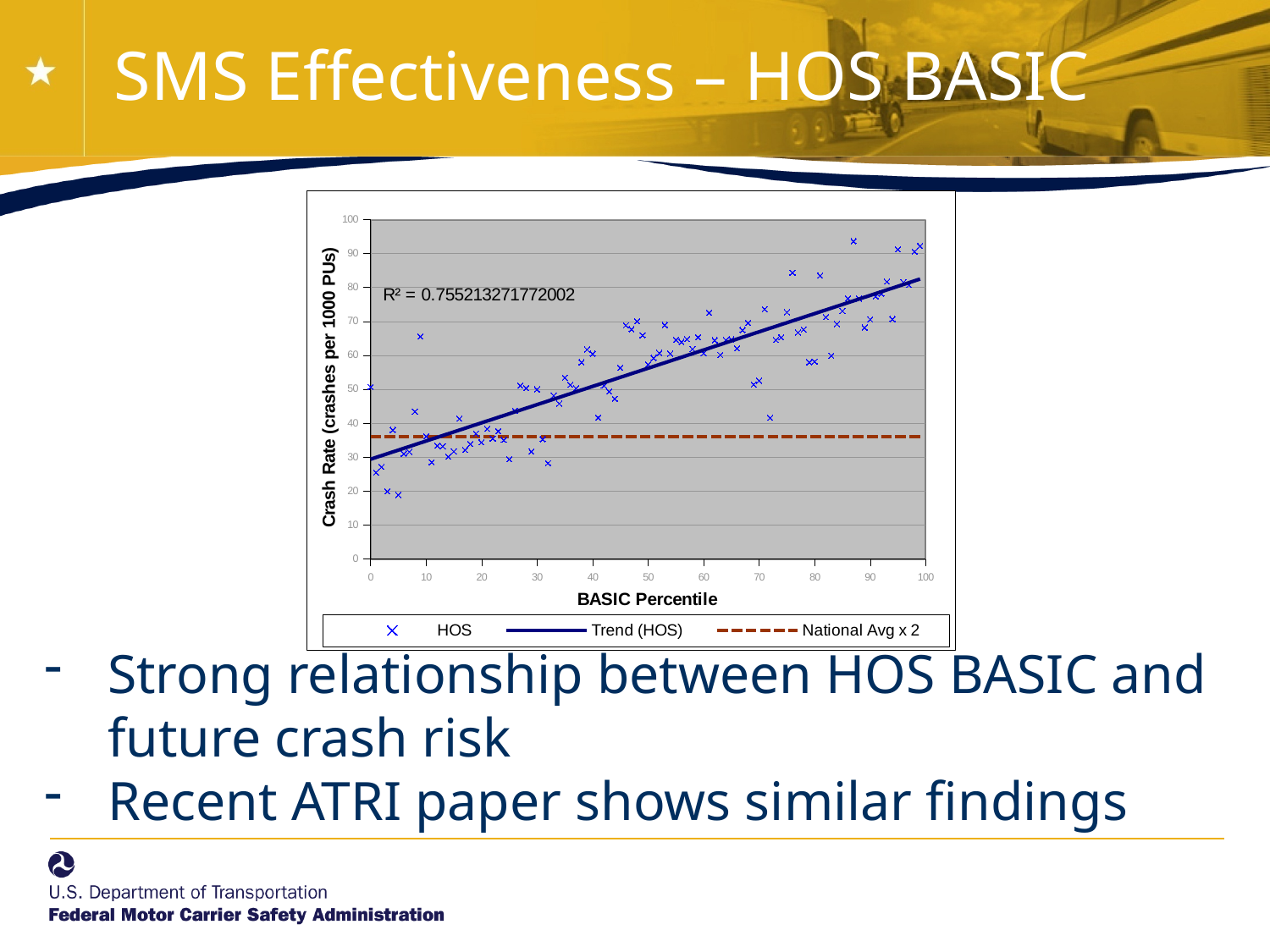
What is the label of the x axis of the chart? BASIC Percentile Is the lowest HOS data point greater or less than 30 crashes per 1000 PUs? less Do the HOS crash rate values generally rise or fall as the BASIC Percentile increases? Rise How many series does the chart legend list? 3 What is the label of the y axis of the chart? Crash Rate (crashes per 1000 PUs) Is the National Avg x 2 line greater or less than 40 on the crash rate axis? less What kind of chart is shown on the slide? Scatter chart Is the Trend (HOS) line at a BASIC Percentile of 100 greater or less than 70 crashes per 1000 PUs? greater What is the maximum value shown on the y axis of the chart? 100 What is the R² value printed on the chart? R² = 0.755213271772002